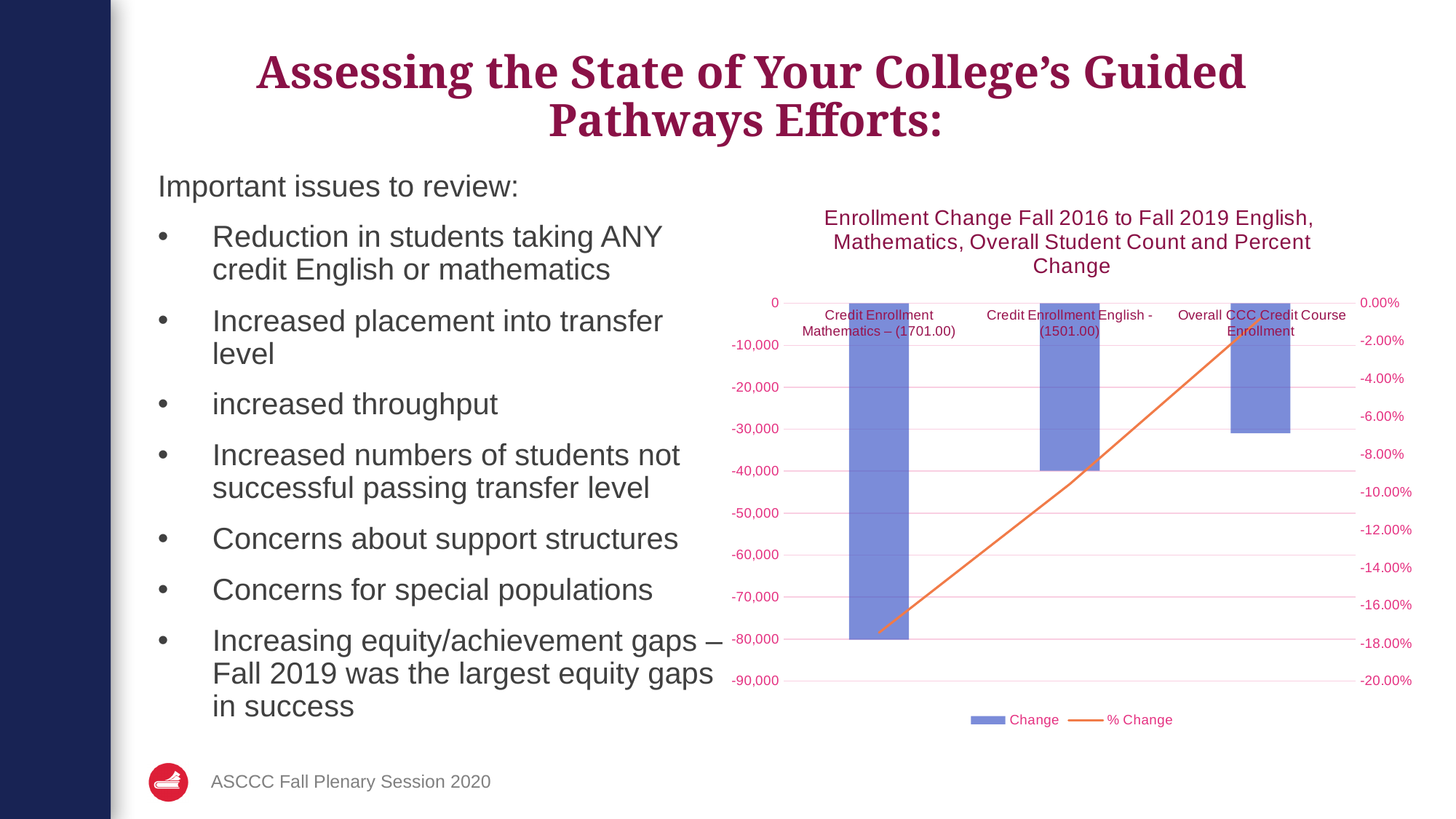
Which category has the lowest (most negative) Change value? Credit Enrollment Mathematics – (1701.00) Is the Change value for Overall CCC Credit Course Enrollment greater or less than -40,000? greater What are the two series named in the chart legend? Change and % Change Which has the larger (less negative) Change value: Credit Enrollment English - (1501.00) or Credit Enrollment Mathematics – (1701.00)? Credit Enrollment English - (1501.00) How many categories are shown on the x axis of the chart? 3 Does the % Change line rise or fall from left to right across the categories? rise Which category has the highest (least negative) Change value? Overall CCC Credit Course Enrollment Is the % Change value for Credit Enrollment Mathematics – (1701.00) greater or less than -16.00%? less Is the Change value for Credit Enrollment Mathematics – (1701.00) greater or less than -70,000? less What type of chart is shown on the slide? A bar chart combined with a line How many series does the chart legend list? 2